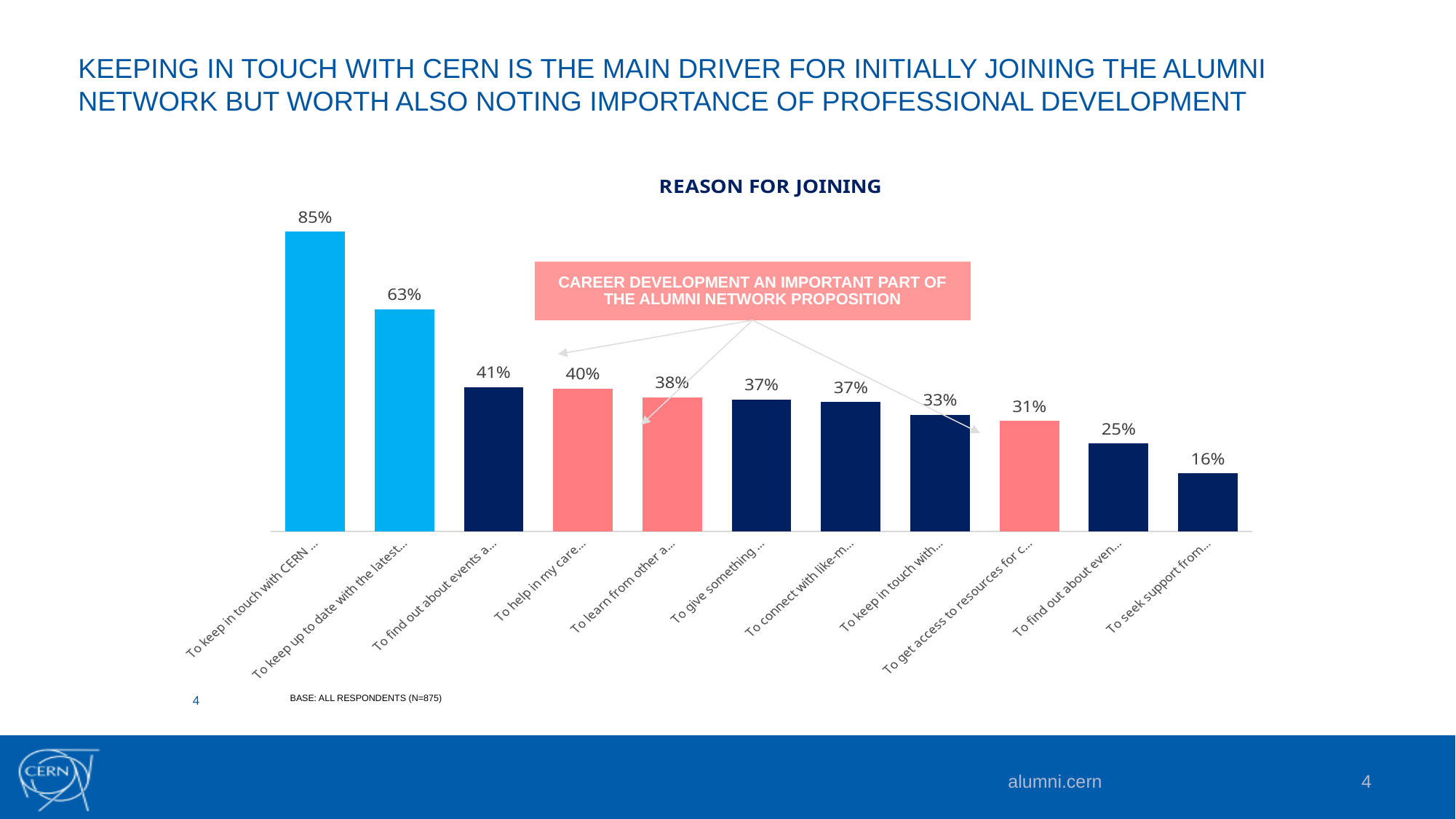
What is the title of the chart? REASON FOR JOINING What is the value for "To help in my care..."? 40% What is the difference between the value for "To keep in touch with CERN ..." and the value for "To keep up to date with the latest..."? 22 percentage points How many bars (reasons) are plotted in the chart? 11 Do the bar values rise or fall from left to right across the chart? Fall What kind of chart is shown on the slide? Bar chart Which reason has the lowest value in the chart? To seek support from... What is the value for "To get access to resources for c..."? 31% What is the value for "To learn from other a..."? 38% Which is larger: the value for "To keep up to date with the latest..." or the value for "To find out about events a..."? To keep up to date with the latest... What is the value for "To keep up to date with the latest..."? 63% Which reason has the highest value in the chart? To keep in touch with CERN ...